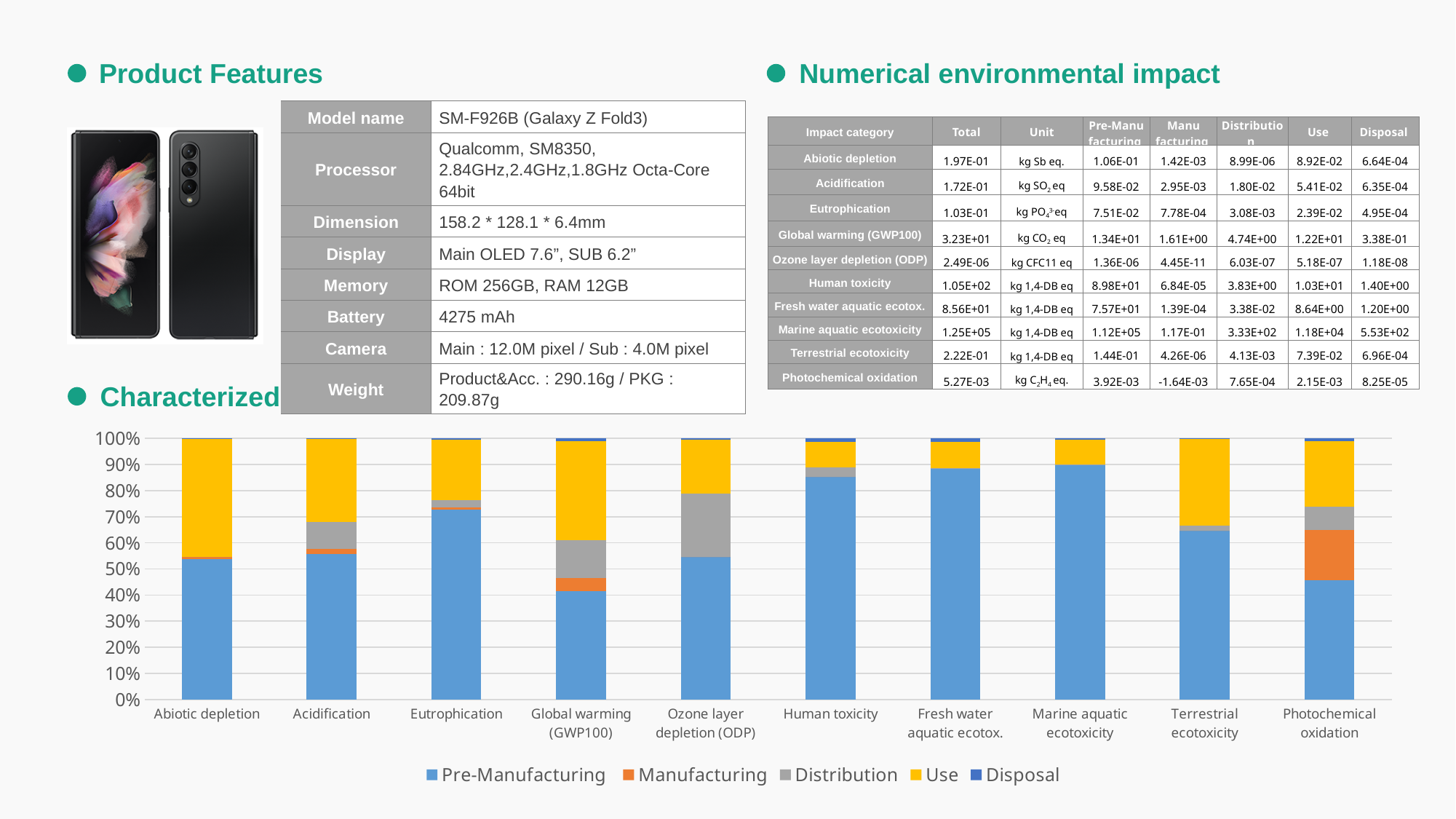
In the stacked bar chart, is the Pre-Manufacturing share for Global warming (GWP100) greater or less than 50%? less In the stacked bar chart, is the Pre-Manufacturing share for Human toxicity greater or less than 80%? greater In the stacked bar chart, which colour represents the Use series? Yellow In the stacked bar chart, which has the larger Use share: Abiotic depletion or Marine aquatic ecotoxicity? Abiotic depletion How many impact categories are plotted along the x axis of the stacked bar chart? 10 In the stacked bar chart, which impact category has the largest Manufacturing share? Photochemical oxidation How many series does the legend of the stacked bar chart list? 5 Which series are listed in the legend of the stacked bar chart? Pre-Manufacturing, Manufacturing, Distribution, Use, Disposal In the stacked bar chart, which impact category has the largest Distribution share? Ozone layer depletion (ODP) What kind of chart is shown at the bottom of the slide? Stacked bar chart In the stacked bar chart, is the Pre-Manufacturing share for Terrestrial ecotoxicity greater or less than 60%? greater In the stacked bar chart, which has the larger Pre-Manufacturing share: Human toxicity or Acidification? Human toxicity